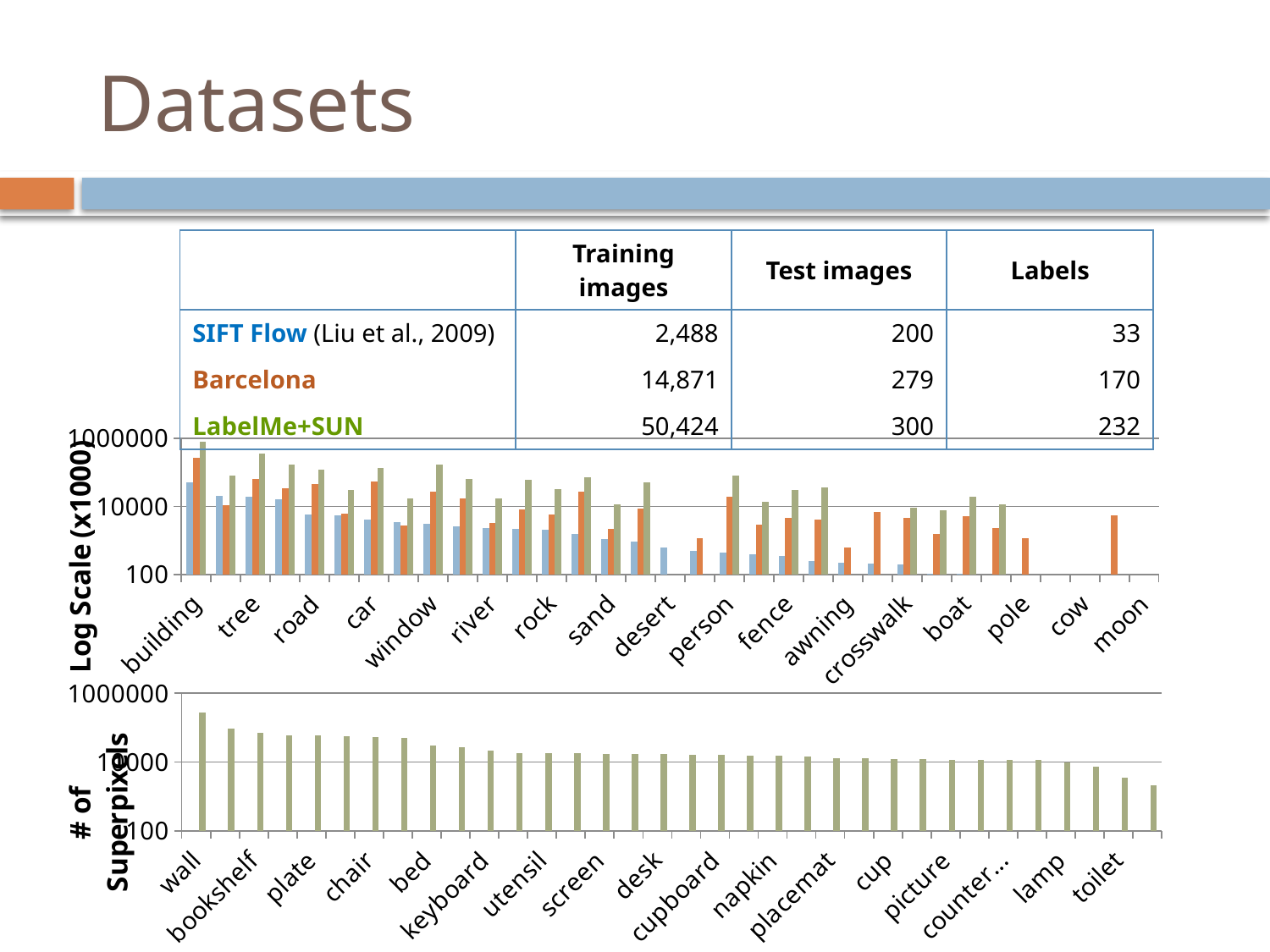
In the bottom chart, is the value for toilet greater or less than 10000? less In the top chart, is the tallest bar for building greater or less than 10000? greater In the bottom chart, is the value for wall greater or less than 10000? greater In the bottom chart, do the values generally rise or fall from left to right along the x axis? fall In the top chart, do the bar heights generally rise or fall from left to right along the x axis? fall What kind of chart is the bottom chart on the slide? bar chart In the top chart, which has the taller tallest bar, building or desert? building In the bottom chart, which labelled category has the highest value? wall What is the y-axis label of the top chart? Log Scale (x1000) What is the y-axis label of the bottom chart? # of Superpixels What kind of chart is the top chart on the slide? bar chart